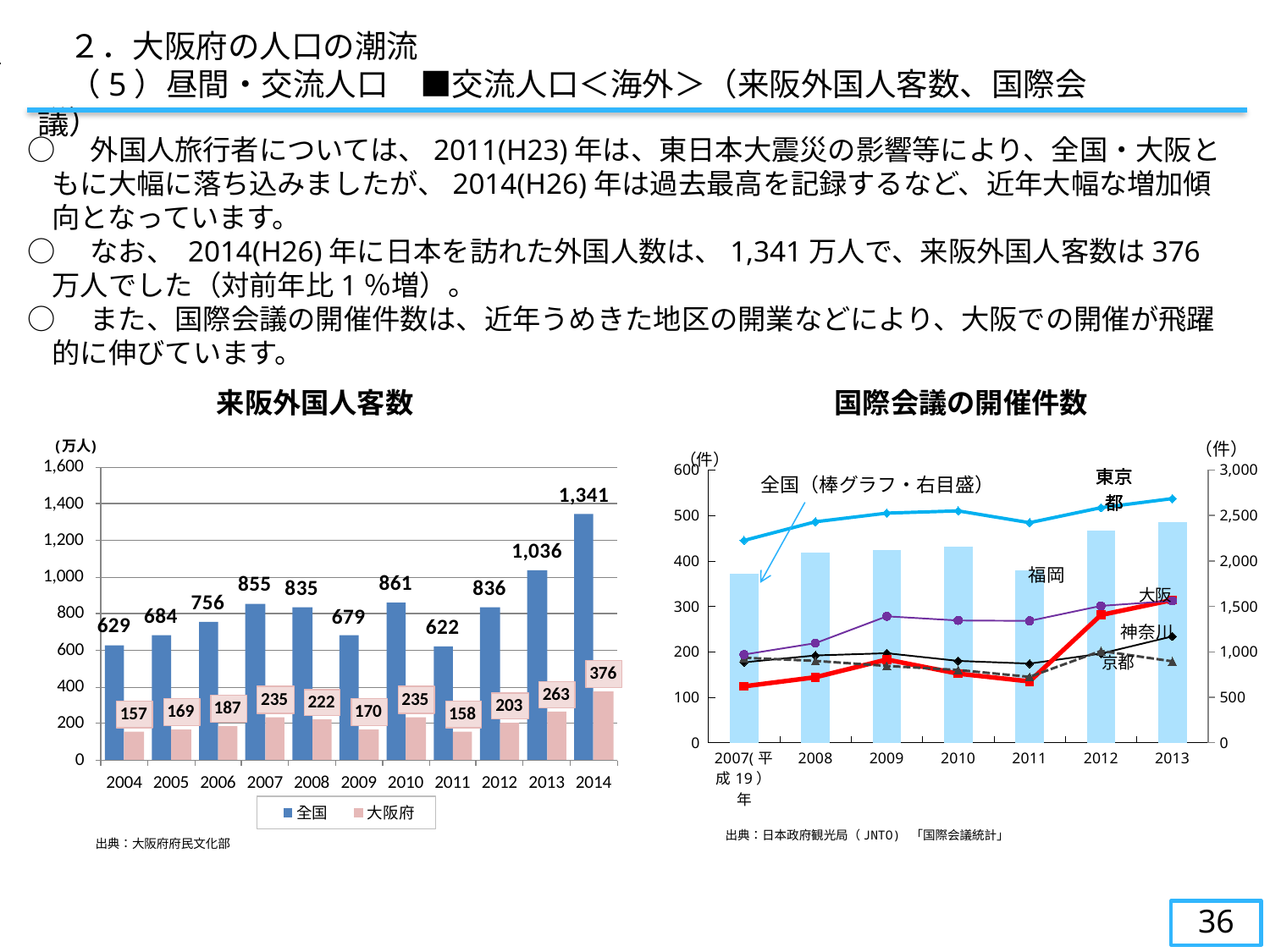
In the 来阪外国人客数 chart, what is the 全国 value for 2014? 1,341 What kind of chart is the 来阪外国人客数 chart? Bar chart In the 来阪外国人客数 chart, do the 全国 values rise or fall from 2011 to 2014? Rise In the 国際会議の開催件数 chart, which line is highest in 2013? 東京都 In the 来阪外国人客数 chart, how many years are shown on the x axis? 11 In the 来阪外国人客数 chart, which year has the highest 全国 value? 2014 In the 来阪外国人客数 chart, which year has the lowest 全国 value? 2011 In the 来阪外国人客数 chart, what is the 大阪府 value for 2013? 263 In the 来阪外国人客数 chart, what is the difference between the 全国 values for 2014 and 2013? 305 In the 国際会議の開催件数 chart, is the 全国 bar for 2013 (right axis) greater or less than 2,000? greater In the 来阪外国人客数 chart, how many series does the legend list? 2 In the 来阪外国人客数 chart, which year has the larger 大阪府 value, 2008 or 2012? 2008